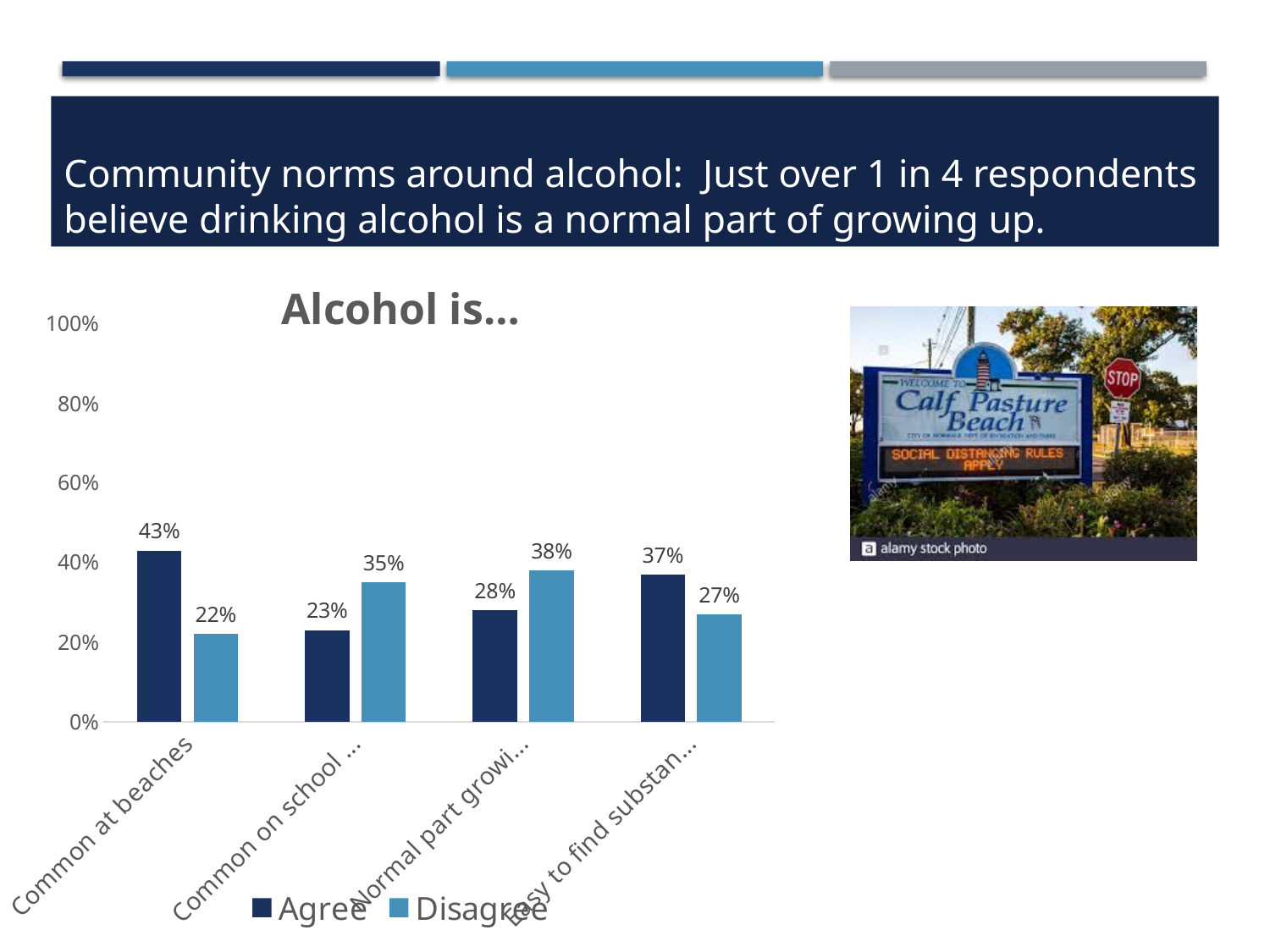
What is the Disagree value for "Common at beaches"? 22% What is the Agree value for "Common at beaches"? 43% What is the Agree value for the third category from the left ("Normal part growi…")? 28% Which category has the lowest Disagree value? Common at beaches How many categories are shown on the x axis? 4 For the second category from the left ("Common on school…"), which is larger, Agree or Disagree? Disagree Which category has the highest Agree value? Common at beaches What is the Disagree value for the fourth category from the left ("Easy to find substan…")? 27% How many series does the legend list? 2 What is the difference between the Agree and Disagree values for "Common at beaches"? 21% What is the title of the chart? Alcohol is… What kind of chart is shown on the slide? Bar chart